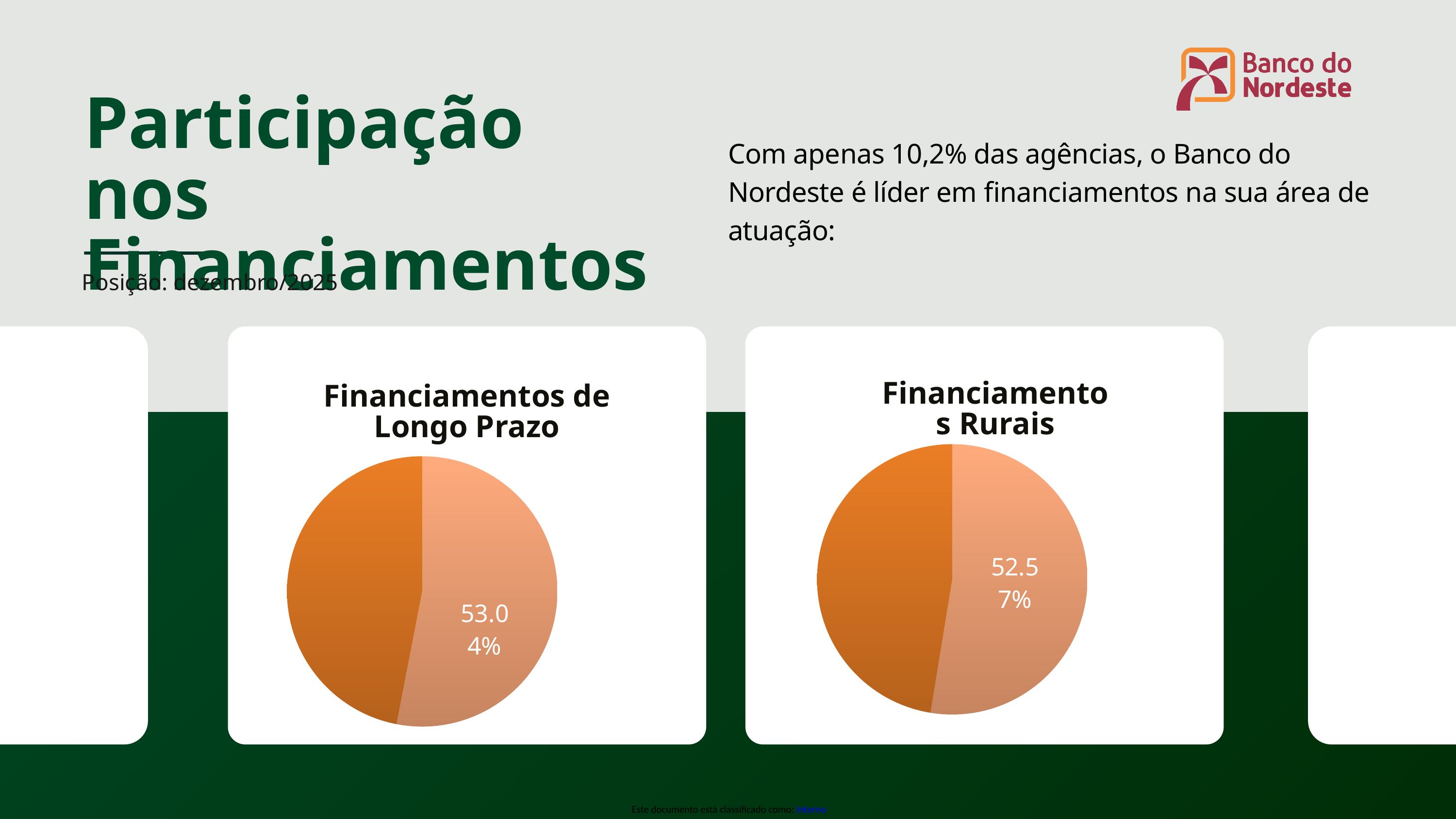
What is the title of the pie chart on the right? Financiamentos Rurais How many slices does the "Financiamentos de Longo Prazo" pie chart have? 2 What is the title of the pie chart on the left? Financiamentos de Longo Prazo What kind of chart is used under the title "Financiamentos de Longo Prazo"? pie chart In the "Financiamentos Rurais" pie chart, what value is printed on the labelled slice? 52.57% Which chart shows the larger labelled share, "Financiamentos de Longo Prazo" or "Financiamentos Rurais"? Financiamentos de Longo Prazo In the "Financiamentos de Longo Prazo" pie chart, what value is printed on the labelled slice? 53.04% What is the difference between the labelled share in the "Financiamentos de Longo Prazo" chart and the labelled share in the "Financiamentos Rurais" chart? 0.47% In the "Financiamentos Rurais" pie chart, is the labelled slice greater or less than 50%? greater In the "Financiamentos de Longo Prazo" pie chart, is the labelled slice greater or less than 50%? greater What kind of chart is used under the title "Financiamentos Rurais"? pie chart How many slices does the "Financiamentos Rurais" pie chart have? 2